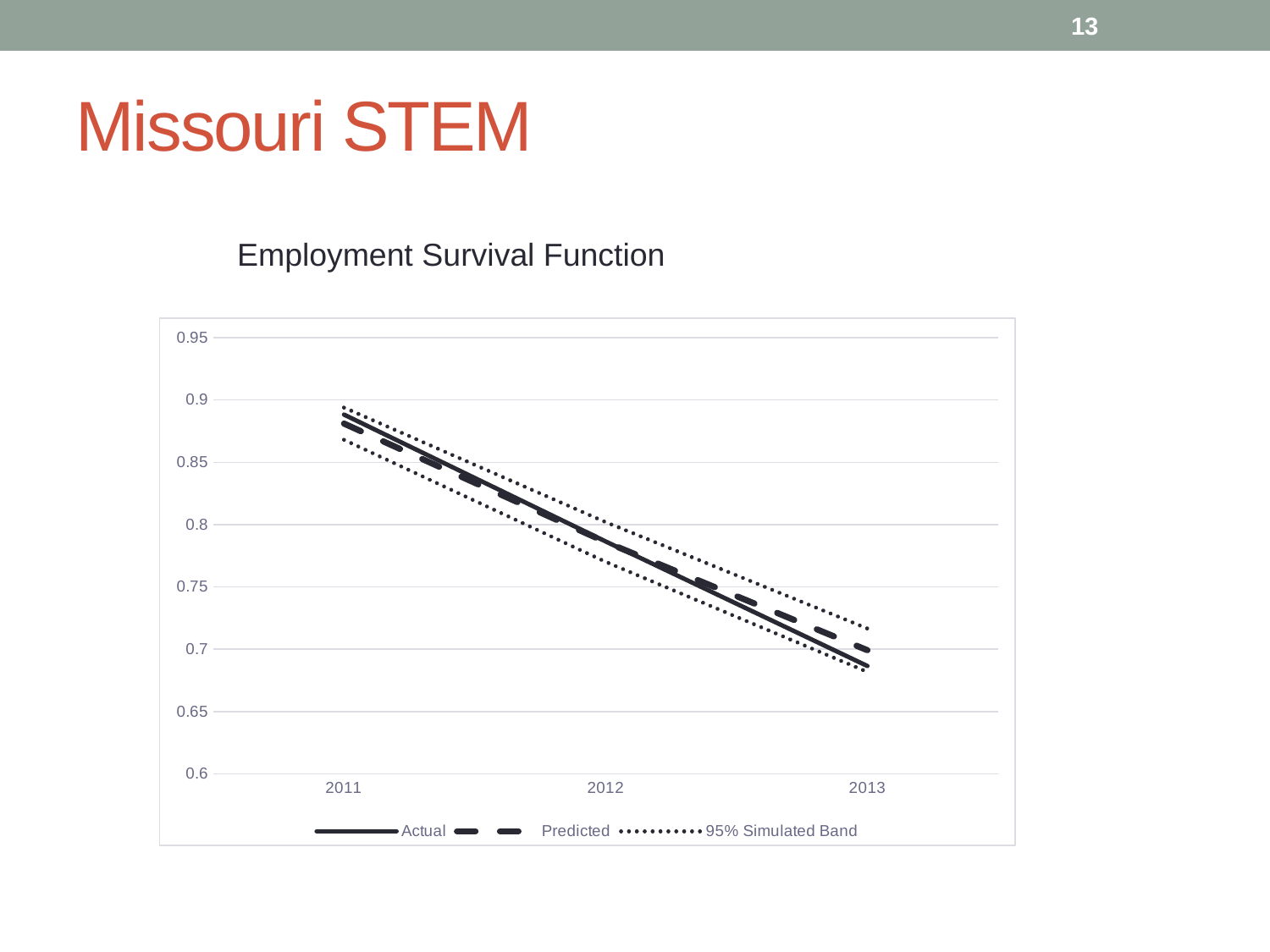
Is the Actual value for 2011 greater or less than 0.85? greater Which is larger, the Actual value for 2011 or the Actual value for 2013? 2011 What is the title of the chart? Employment Survival Function In which year is the Actual value lowest? 2013 What kind of chart is shown on the slide? line chart Is the Actual value for 2012 greater or less than 0.75? greater Is the Actual value for 2013 greater or less than 0.75? less How many series does the legend list? 3 In which year is the Actual value highest? 2011 Do the Actual values rise or fall from 2011 to 2013? fall How many years are shown on the x axis? 3